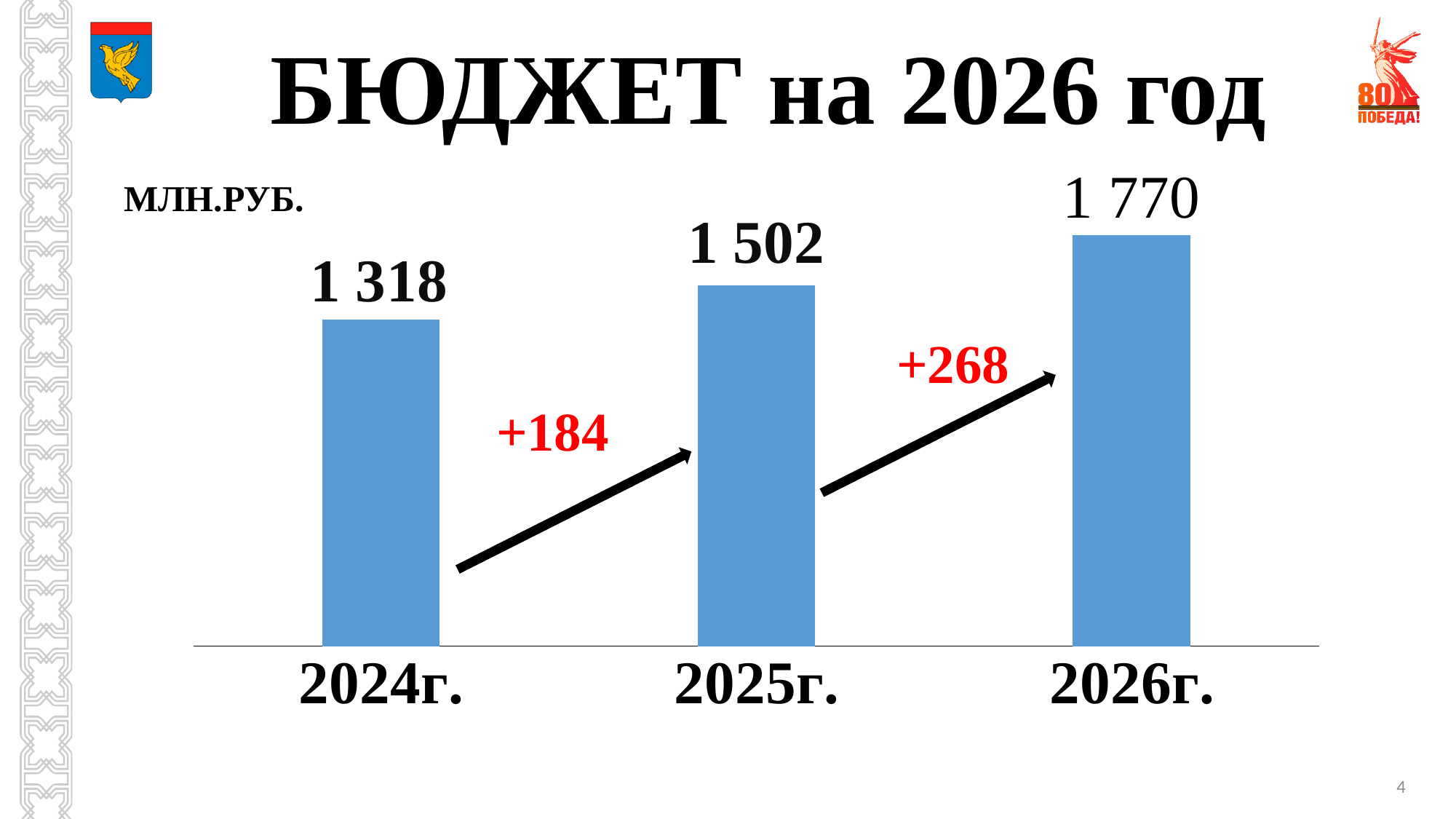
What is the budget value for 2024г.? 1 318 Do the values rise or fall from 2024г. to 2026г.? rise What kind of chart is shown on the slide? bar chart What is the difference between the 2026г. and 2025г. values? 268 Which year has the lowest budget value? 2024г. What is the difference between the 2026г. and 2024г. values? 452 What is the budget value for 2026г.? 1 770 Which year has the highest budget value? 2026г. What is the budget value for 2025г.? 1 502 How many years are shown in the chart? 3 Which is larger, the value for 2025г. or the value for 2026г.? 2026г. What is the difference between the 2025г. and 2024г. values? 184